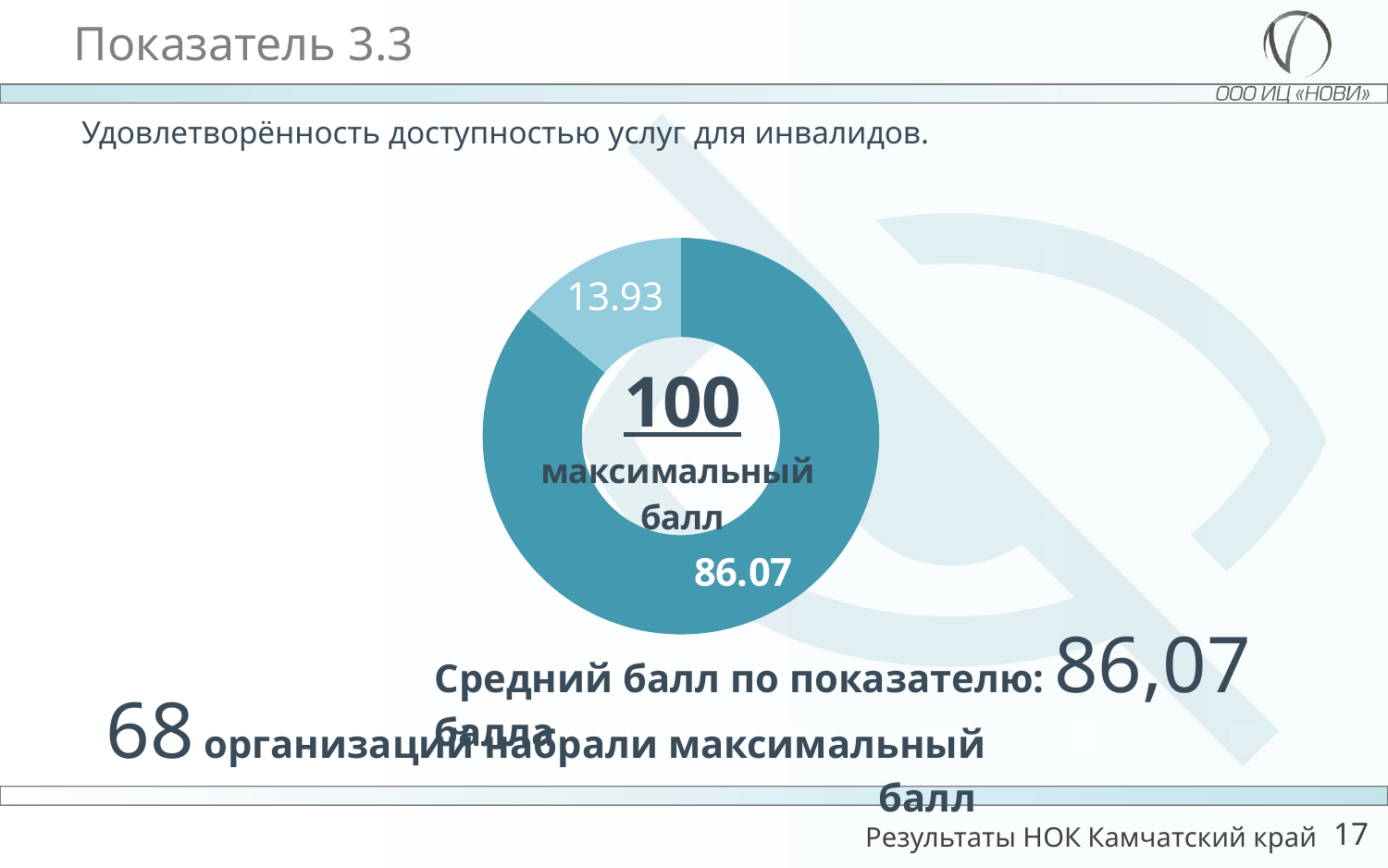
What is the largest value shown in the donut chart? 86.07 What is the total of the two slice values in the donut chart? 100 What kind of chart is shown on the slide? Donut (pie) chart What text accompanies the number in the centre of the donut chart? максимальный балл What value is printed on the smaller, light teal slice of the donut chart? 13.93 What value is printed on the larger, dark teal slice of the donut chart? 86.07 Which slice is larger: the dark teal slice or the light teal slice? The dark teal slice What is the difference between the two slice values in the donut chart? 72.14 What number is printed in the centre of the donut chart? 100 What share of the whole donut does the 86.07 slice represent? 86.07% What is the smallest value shown in the donut chart? 13.93 How many slices does the donut chart have? 2